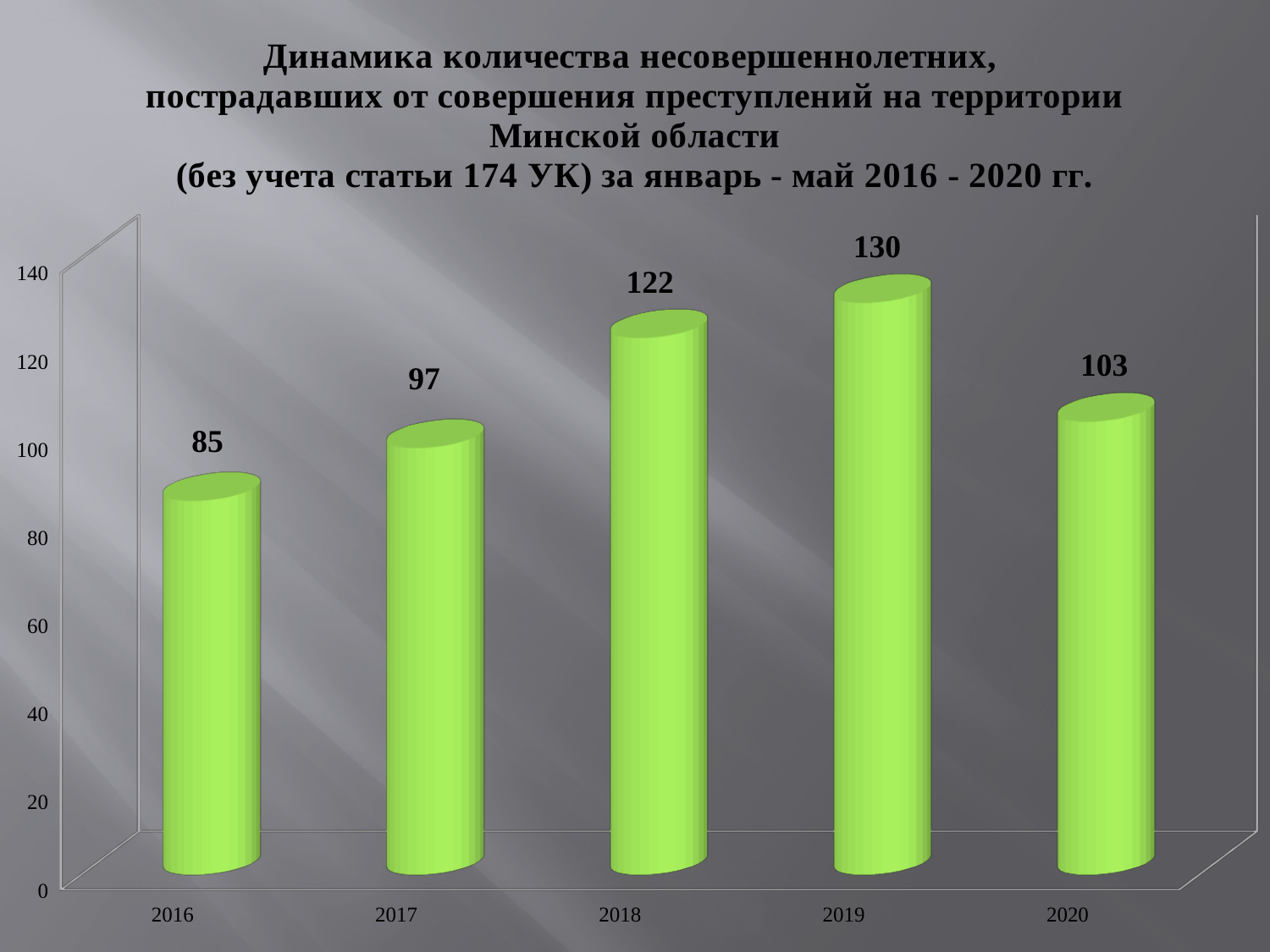
Which year has the highest value? 2019 Which year has the lowest value? 2016 Which is larger, the value for 2017 or the value for 2020? 2020 Do the values rise or fall from 2016 to 2019? rise Is the value for 2019 greater or less than 120? greater What is the difference between the values for 2018 and 2020? 19 What is the value for 2018? 122 What kind of chart is shown on the slide? bar chart What is the value for 2020? 103 What is the value for 2016? 85 What is the difference between the values for 2019 and 2016? 45 How many years are shown on the chart? 5